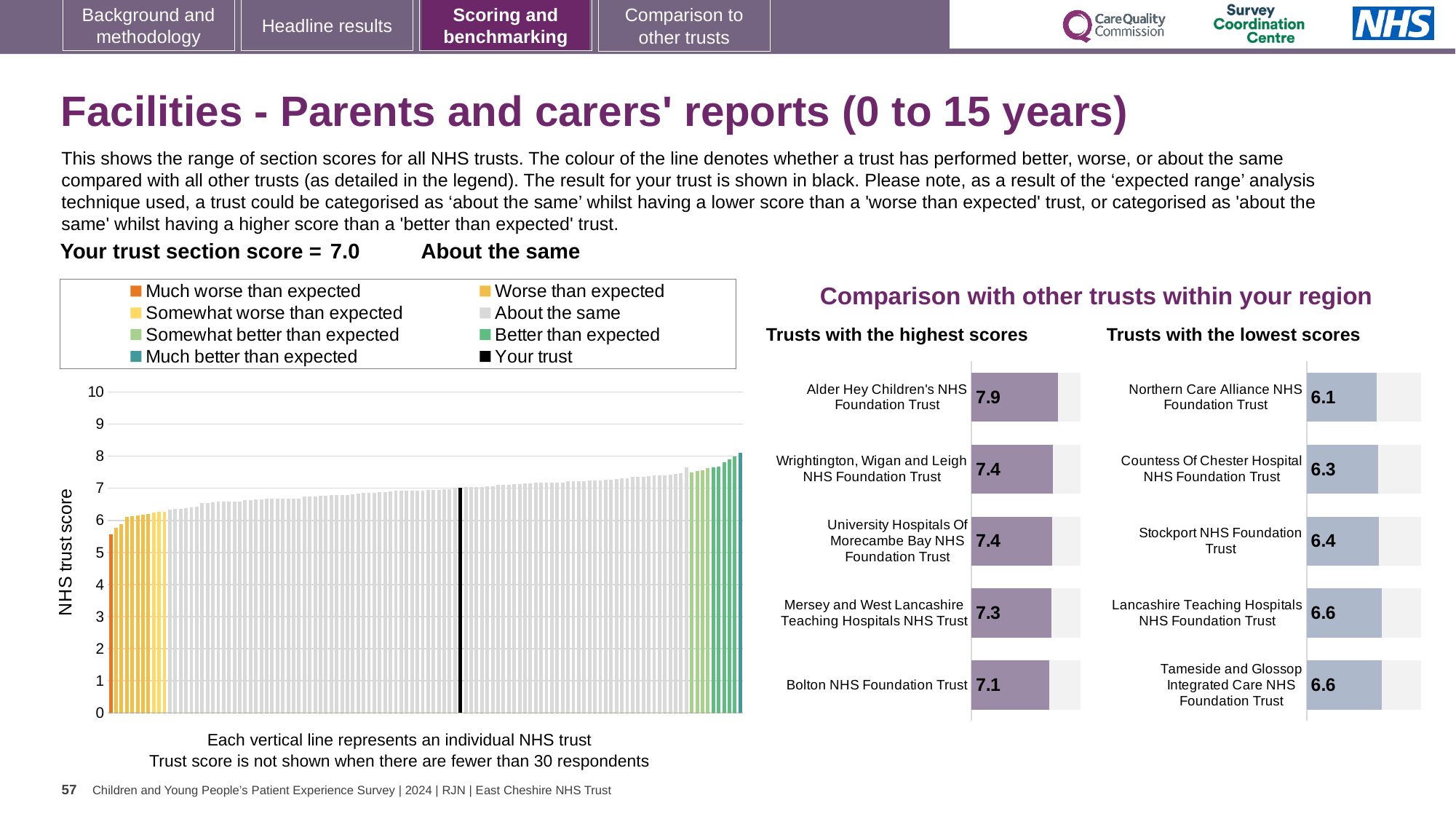
On the main 'NHS trust score' chart, how many entries does the legend list? 8 On the main 'NHS trust score' chart, do the bar values rise or fall from left to right? Rise On the main 'NHS trust score' chart, what colour represents 'Your trust' in the legend? Black On the 'Trusts with the highest scores' chart, what is the score for Alder Hey Children's NHS Foundation Trust? 7.9 On the 'Trusts with the lowest scores' chart, what is the score for Northern Care Alliance NHS Foundation Trust? 6.1 On the 'Trusts with the highest scores' chart, which trust has the lowest score? Bolton NHS Foundation Trust How many trusts are shown on the 'Trusts with the highest scores' chart? 5 On the 'Trusts with the lowest scores' chart, which trust has the lowest score? Northern Care Alliance NHS Foundation Trust What kind of chart is the main 'NHS trust score' chart on the left? Bar chart On the 'Trusts with the highest scores' chart, what is the difference between the scores of Alder Hey Children's NHS Foundation Trust and Bolton NHS Foundation Trust? 0.8 On the main 'NHS trust score' chart, is the value of the leftmost (orange) bar greater or less than 6? less On the 'Trusts with the lowest scores' chart, which has the higher score: Countess Of Chester Hospital NHS Foundation Trust or Stockport NHS Foundation Trust? Stockport NHS Foundation Trust